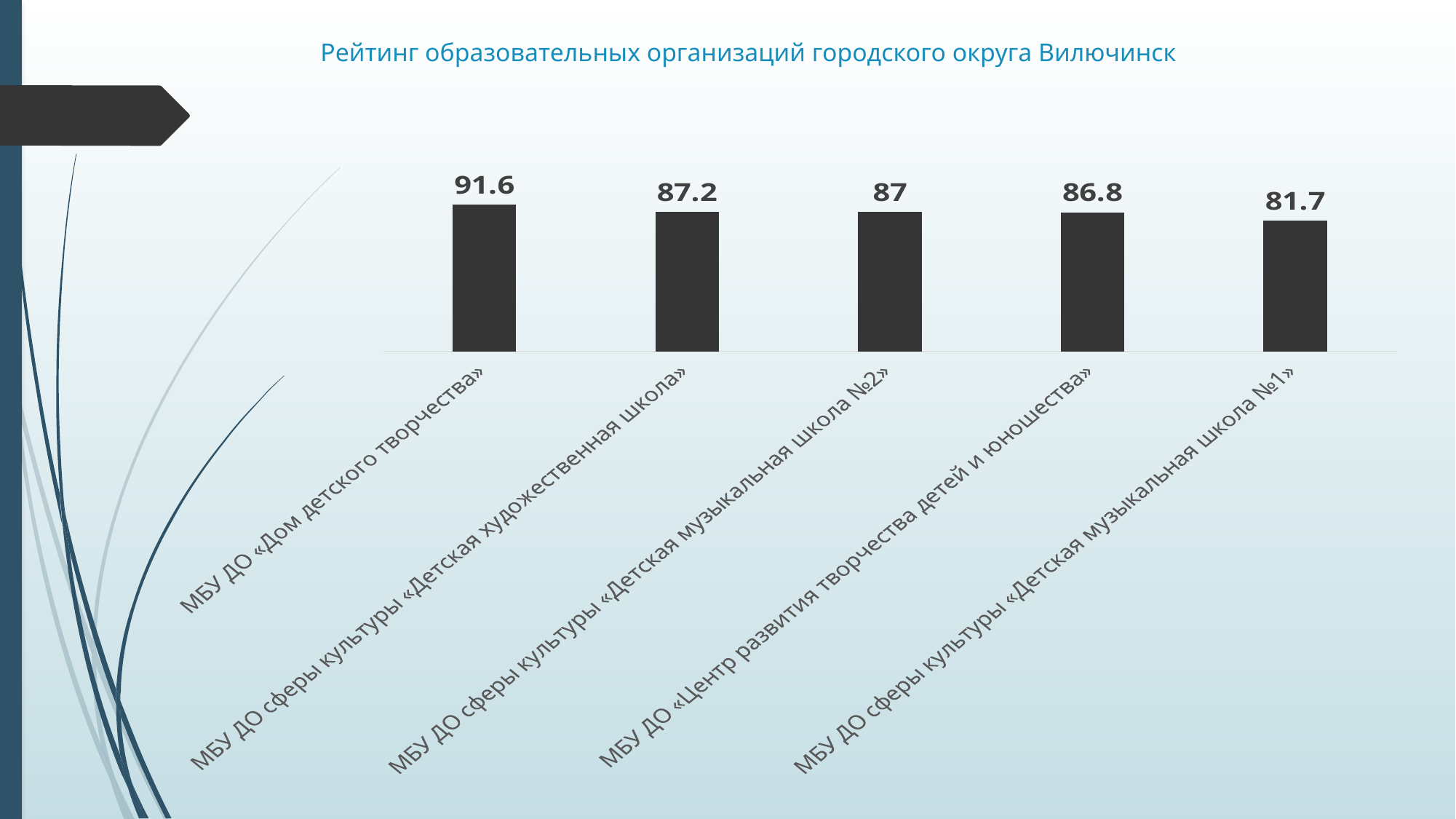
What is the value for МБУ ДО сферы культуры «Детская музыкальная школа №2»? 87 What is the value for МБУ ДО сферы культуры «Детская музыкальная школа №1»? 81.7 How many organisations are shown in the chart? 5 What is the value for МБУ ДО «Центр развития творчества детей и юношества»? 86.8 Which has a larger value: МБУ ДО сферы культуры «Детская художественная школа» or МБУ ДО сферы культуры «Детская музыкальная школа №1»? МБУ ДО сферы культуры «Детская художественная школа» Do the values rise or fall from left to right along the x axis? Fall What is the difference between the values for МБУ ДО «Дом детского творчества» and МБУ ДО сферы культуры «Детская музыкальная школа №1»? 9.9 What is the value for МБУ ДО «Дом детского творчества»? 91.6 What kind of chart is shown on the slide? Bar chart Which organisation has the highest value? МБУ ДО «Дом детского творчества» What is the value for МБУ ДО сферы культуры «Детская художественная школа»? 87.2 Which organisation has the lowest value? МБУ ДО сферы культуры «Детская музыкальная школа №1»